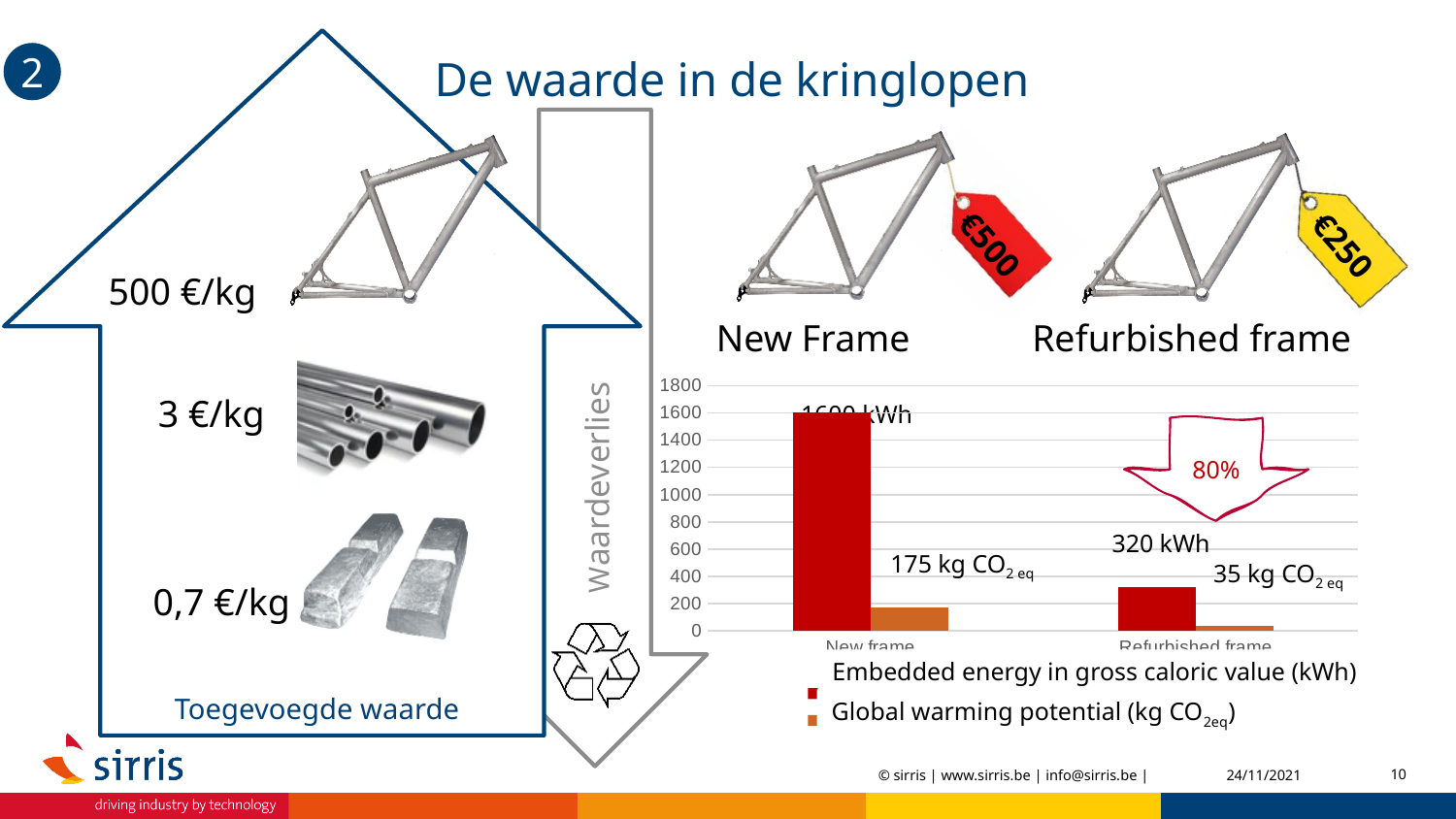
What is the global warming potential for the New frame? 175 kg CO2 eq What kind of chart is shown on the slide? bar chart Which category has the highest embedded energy value? New frame What is the embedded energy value for the Refurbished frame? 320 kWh What percentage reduction is indicated by the arrow above the Refurbished frame bars? 80% What is the embedded energy value for the New frame? 1600 kWh How many categories are shown on the x axis of the chart? 2 Is the embedded energy value for the Refurbished frame greater or less than 400? less Which category has the lowest global warming potential? Refurbished frame What is the global warming potential for the Refurbished frame? 35 kg CO2 eq What is the difference in embedded energy between the New frame and the Refurbished frame? 1280 kWh How many series does the chart legend list? 2